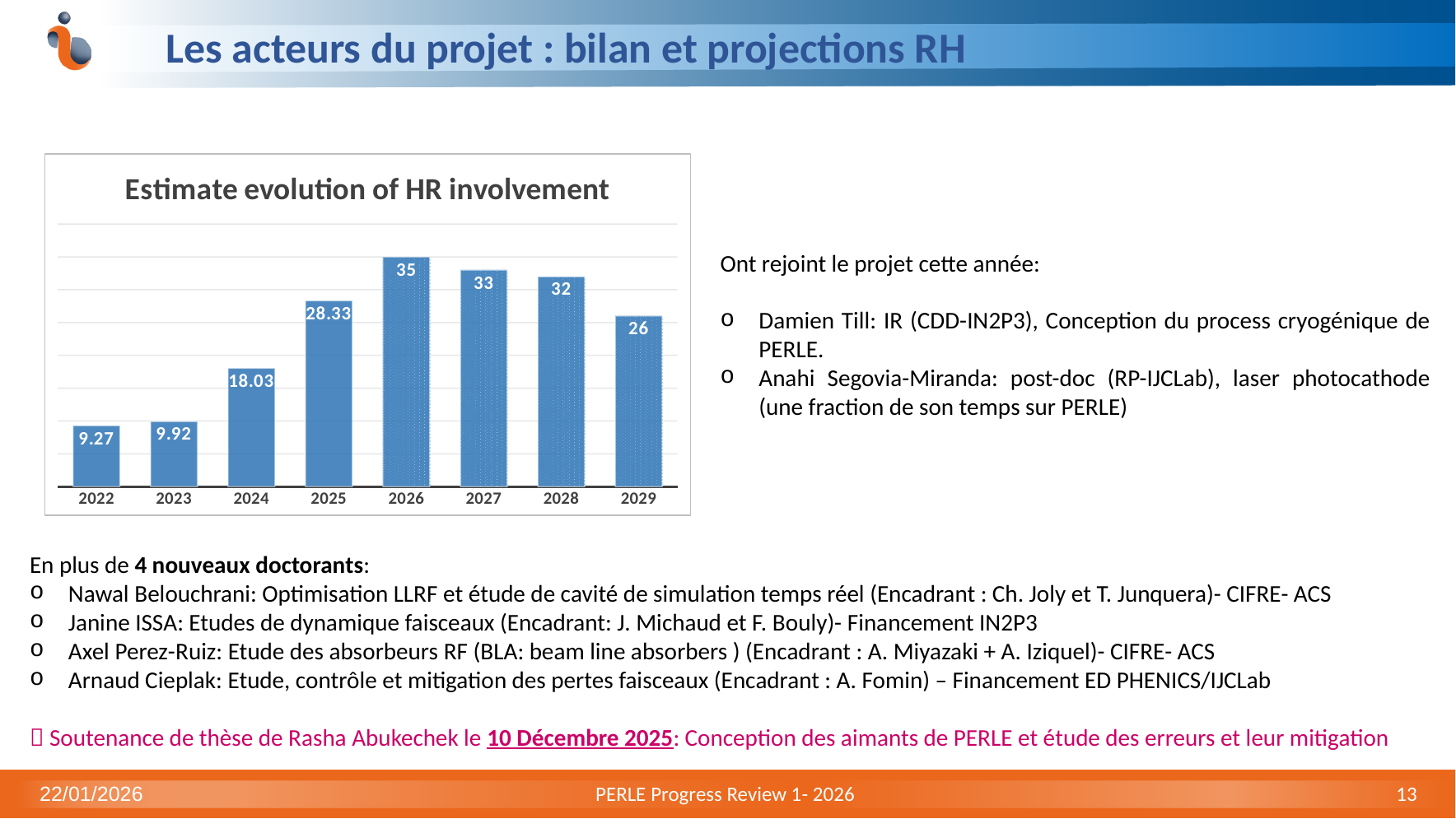
What is the value for 2029 in the chart? 26 What is the value for 2025 in the chart? 28.33 What is the difference between the values for 2024 and 2023? 8.11 How many years are shown on the x axis of the chart? 8 Which year has the highest value in the chart? 2026 What is the value for 2022 in the chart? 9.27 What is the difference between the values for 2026 and 2029? 9 Which year has the lowest value in the chart? 2022 Which is larger, the value for 2027 or the value for 2028? 2027 Do the values rise or fall from 2022 to 2026? Rise What kind of chart is shown on the slide? Bar chart What is the title of the chart? Estimate evolution of HR involvement